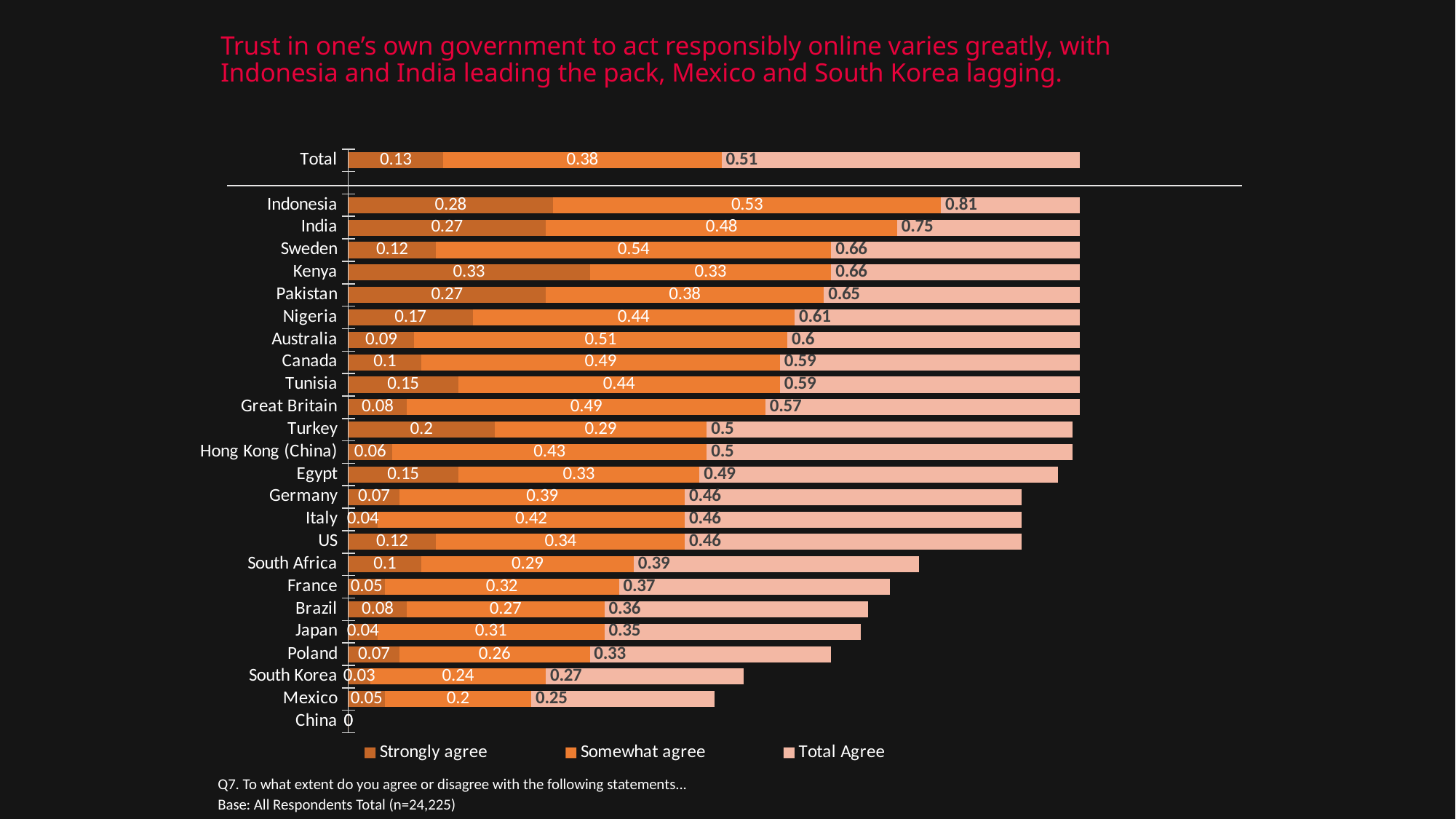
What is the Somewhat agree value for Sweden? 0.54 How many series does the legend list? 3 What are the three legend entries of the chart? Strongly agree, Somewhat agree, Total Agree How many countries are listed below the Total row? 24 What kind of chart is shown on the slide? bar chart What is the difference between the Total Agree values for Indonesia and India? 0.06 Which country has the highest Strongly agree value? Kenya Which has the larger Strongly agree value, Turkey or Nigeria? Turkey What is the Total Agree value for Mexico? 0.25 What is the Strongly agree value for Indonesia? 0.28 Which country has the highest Total Agree value? Indonesia What is the Total Agree value for the Total row? 0.51